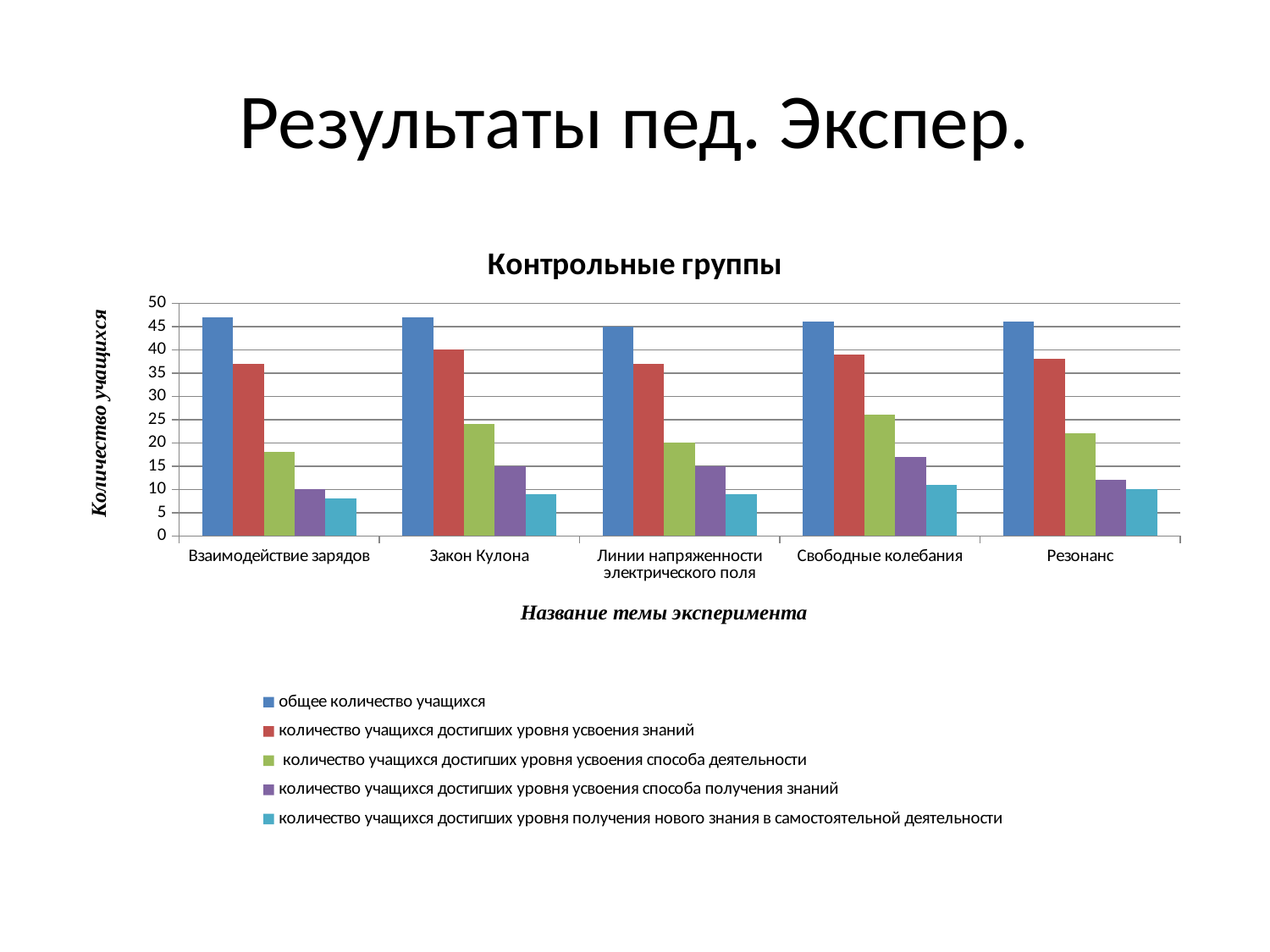
What is the label of the vertical axis? Количество учащихся Is the value of 'количество учащихся достигших уровня усвоения знаний' for 'Линии напряженности электрического поля' greater or less than 40? less Is the value of 'количество учащихся достигших уровня получения нового знания в самостоятельной деятельности' for 'Взаимодействие зарядов' greater or less than 10? less How many categories (experiment topics) are shown on the x axis? 5 Which category has the lowest value for 'количество учащихся достигших уровня усвоения способа деятельности'? Взаимодействие зарядов Which category has the highest value for 'количество учащихся достигших уровня усвоения знаний'? Закон Кулона Is the value of 'общее количество учащихся' for 'Закон Кулона' greater or less than 45? greater What is the title of the chart? Контрольные группы Which is larger for 'Резонанс': 'количество учащихся достигших уровня усвоения способа деятельности' or 'количество учащихся достигших уровня усвоения способа получения знаний'? количество учащихся достигших уровня усвоения способа деятельности How many series does the legend list? 5 What type of chart is shown on the slide? bar chart